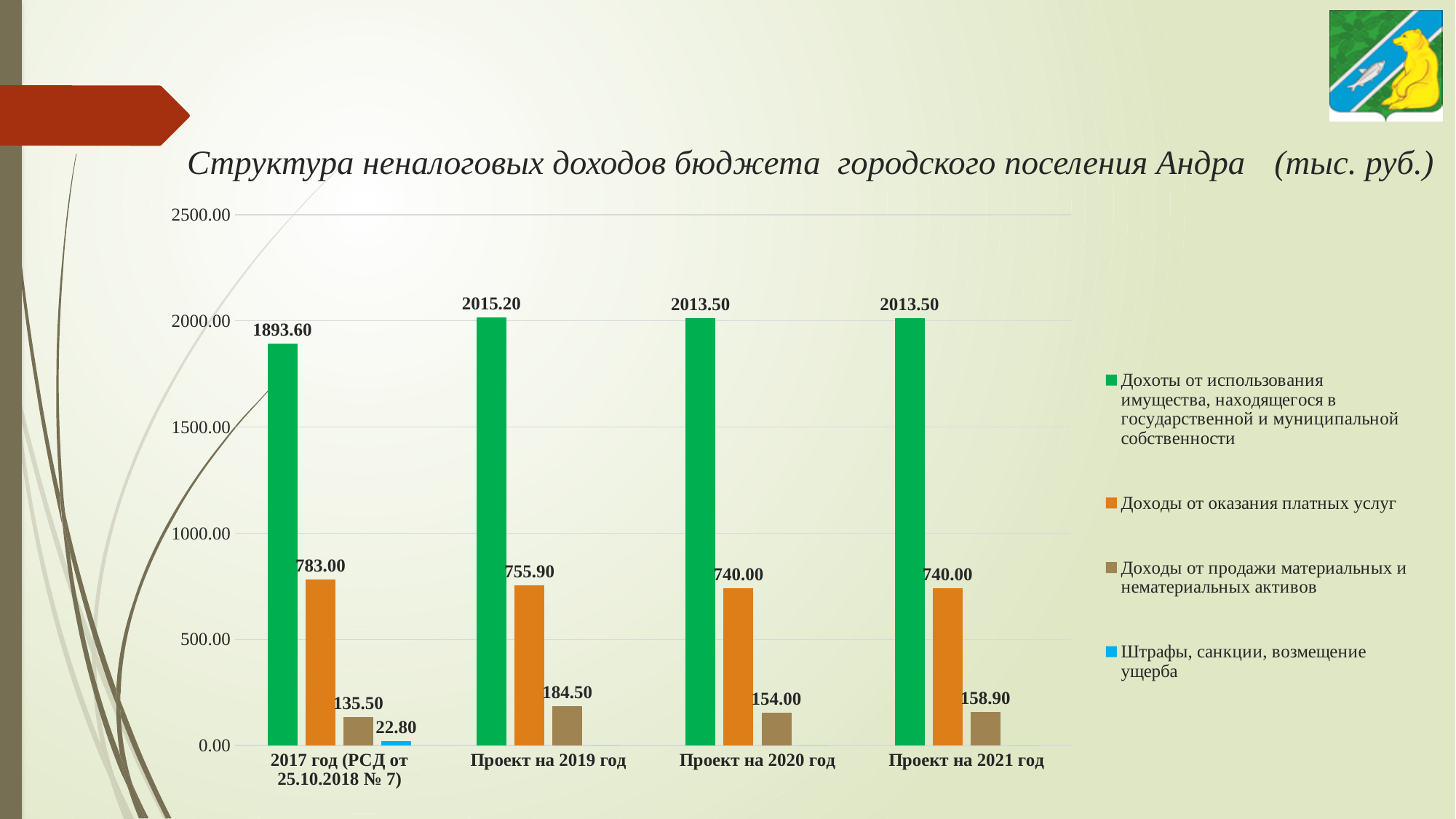
What is the value of 'Доходы от использования имущества, находящегося в государственной и муниципальной собственности' for '2017 год (РСД от 25.10.2018 № 7)'? 1893.60 How many categories are shown on the x axis? 4 What kind of chart is shown on the slide? bar chart How many series does the legend list? 4 What is the value of 'Доходы от продажи материальных и нематериальных активов' for 'Проект на 2020 год'? 154.00 What is the value of 'Доходы от оказания платных услуг' for 'Проект на 2019 год'? 755.90 What is the value of 'Штрафы, санкции, возмещение ущерба' for '2017 год (РСД от 25.10.2018 № 7)'? 22.80 In which category is 'Доходы от использования имущества, находящегося в государственной и муниципальной собственности' the highest? Проект на 2019 год Which is larger: 'Доходы от продажи материальных и нематериальных активов' for 'Проект на 2019 год' or for 'Проект на 2021 год'? Проект на 2019 год What is the difference between 'Доходы от оказания платных услуг' in '2017 год (РСД от 25.10.2018 № 7)' and in 'Проект на 2020 год'? 43.00 Is the value of 'Доходы от использования имущества, находящегося в государственной и муниципальной собственности' for '2017 год (РСД от 25.10.2018 № 7)' greater or less than 2000.00? less In which category is 'Доходы от продажи материальных и нематериальных активов' the lowest? 2017 год (РСД от 25.10.2018 № 7)